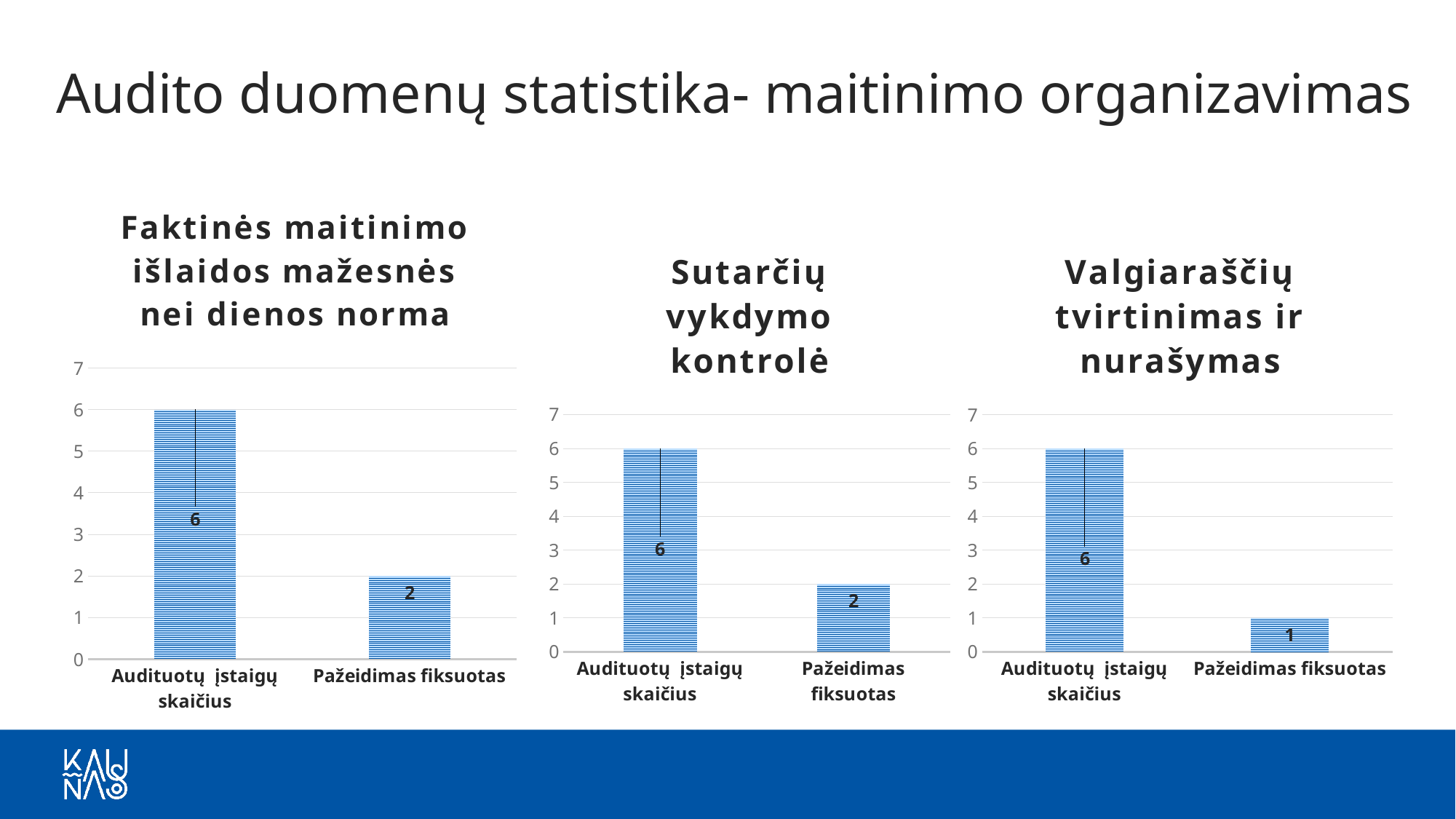
In the chart titled "Sutarčių vykdymo kontrolė", is the value for "Audituotų įstaigų skaičius" greater or less than 5? greater In the chart titled "Faktinės maitinimo išlaidos mažesnės nei dienos norma", what is the value for "Pažeidimas fiksuotas"? 2 In the chart titled "Valgiaraščių tvirtinimas ir nurašymas", what is the difference between "Audituotų įstaigų skaičius" and "Pažeidimas fiksuotas"? 5 How many categories are shown in the chart titled "Faktinės maitinimo išlaidos mažesnės nei dienos norma"? 2 What type of chart is the chart titled "Sutarčių vykdymo kontrolė"? Bar chart In the chart titled "Valgiaraščių tvirtinimas ir nurašymas", which category has the lowest value? Pažeidimas fiksuotas In the chart titled "Faktinės maitinimo išlaidos mažesnės nei dienos norma", what is the difference between "Audituotų įstaigų skaičius" and "Pažeidimas fiksuotas"? 4 In the chart titled "Faktinės maitinimo išlaidos mažesnės nei dienos norma", what is the value for "Audituotų įstaigų skaičius"? 6 In the chart titled "Valgiaraščių tvirtinimas ir nurašymas", what is the value for "Audituotų įstaigų skaičius"? 6 In the chart titled "Sutarčių vykdymo kontrolė", which category has the highest value? Audituotų įstaigų skaičius In the chart titled "Valgiaraščių tvirtinimas ir nurašymas", what is the value for "Pažeidimas fiksuotas"? 1 In the chart titled "Sutarčių vykdymo kontrolė", what is the value for "Pažeidimas fiksuotas"? 2